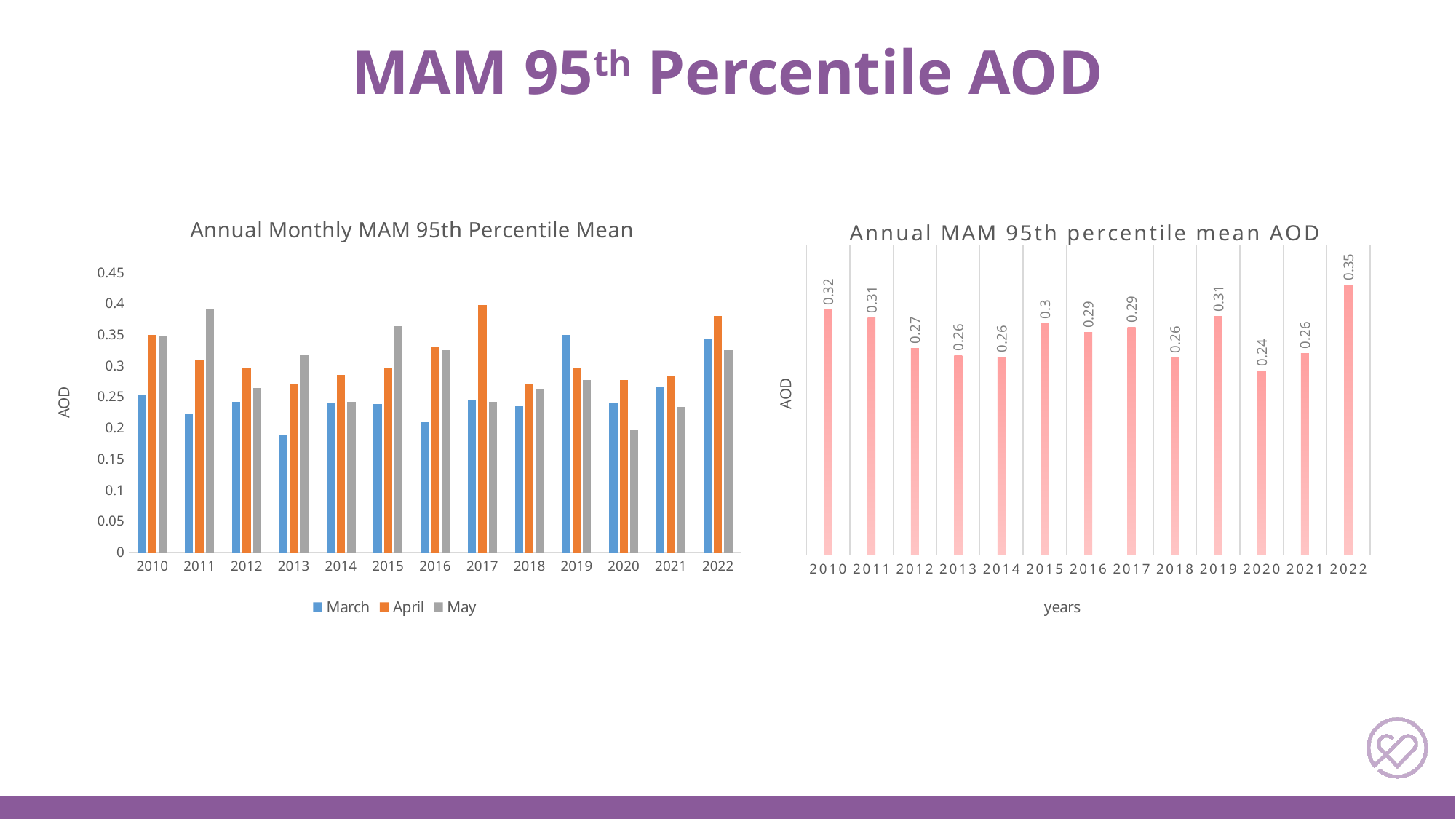
In the chart titled "Annual MAM 95th percentile mean AOD" on the right, what is the difference between the values for 2022 and 2020? 0.11 In the chart titled "Annual MAM 95th percentile mean AOD" on the right, what is the value for 2022? 0.35 What kind of chart is the chart titled "Annual Monthly MAM 95th Percentile Mean" on the left? bar chart In the chart titled "Annual MAM 95th percentile mean AOD" on the right, what is the value for 2010? 0.32 In the chart titled "Annual Monthly MAM 95th Percentile Mean" on the left, is the April value for 2017 greater or less than 0.35? greater In the chart titled "Annual Monthly MAM 95th Percentile Mean" on the left, which is larger for 2019: the March value or the April value? March In the chart titled "Annual Monthly MAM 95th Percentile Mean" on the left, what are the legend entries? March, April, May In the chart titled "Annual Monthly MAM 95th Percentile Mean" on the left, is the May value for 2020 greater or less than 0.25? less In the chart titled "Annual MAM 95th percentile mean AOD" on the right, which year has the lowest value? 2020 In the chart titled "Annual Monthly MAM 95th Percentile Mean" on the left, how many series does the legend list? 3 In the chart titled "Annual MAM 95th percentile mean AOD" on the right, which year has the highest value? 2022 In the chart titled "Annual MAM 95th percentile mean AOD" on the right, how many years are plotted? 13